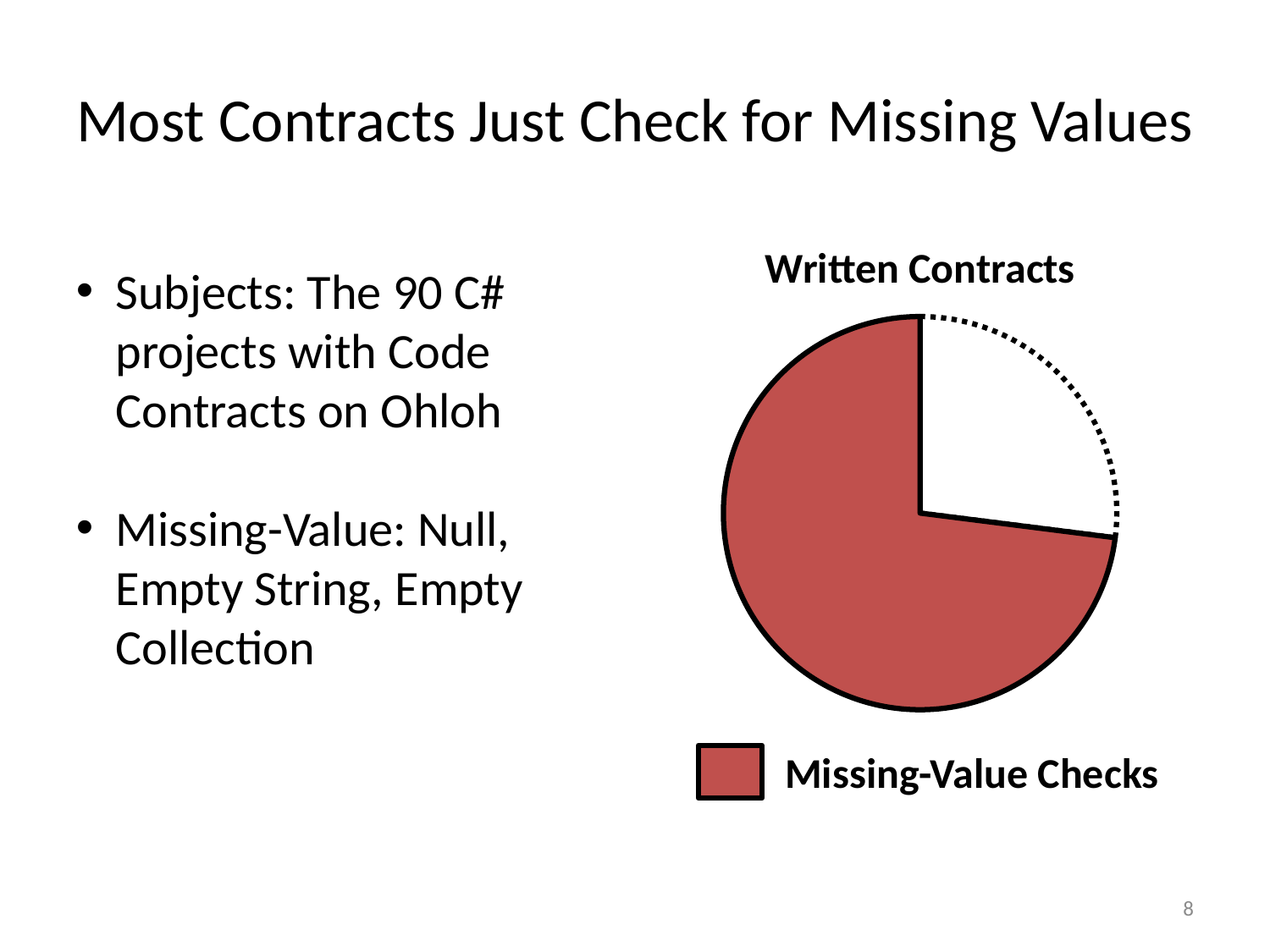
Does the Missing-Value Checks slice make up more or less than half of the pie chart? more What is the label of the legend entry shown below the pie chart? Missing-Value Checks How many slices does the pie chart have? 2 Which is larger in the pie chart: the Missing-Value Checks slice or the remaining unlabeled slice? Missing-Value Checks Which slice of the pie chart is the smallest? the unlabeled (white) slice What kind of chart is shown on the slide? pie chart What is the title of the pie chart? Written Contracts How many entries does the legend of the pie chart list? 1 Which slice of the pie chart is the largest? Missing-Value Checks